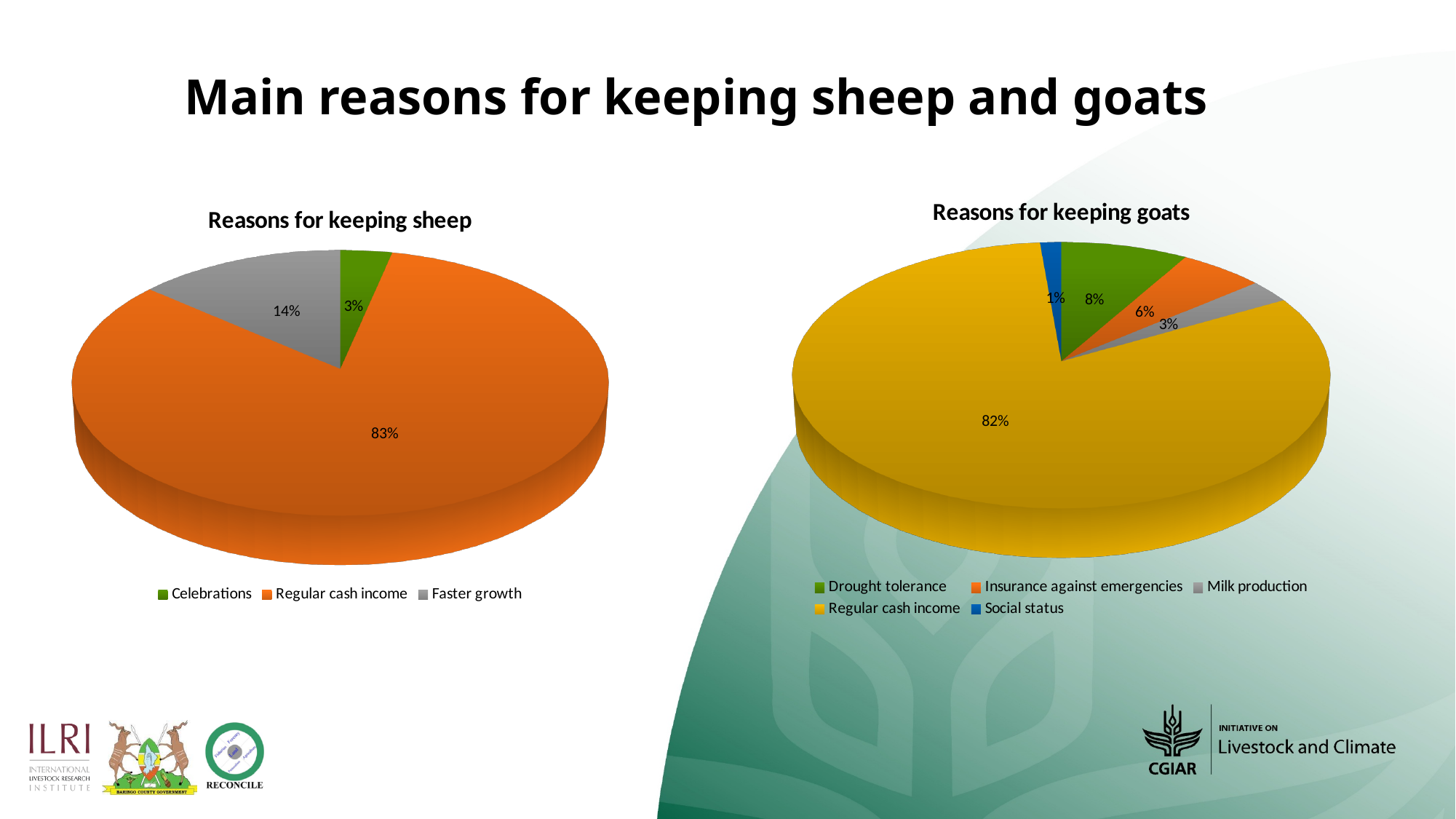
What type of chart is 'Reasons for keeping sheep'? Pie chart In the 'Reasons for keeping goats' chart, what share is Social status? 1% In the 'Reasons for keeping goats' chart, which is larger: Insurance against emergencies or Milk production? Insurance against emergencies How many categories does the legend of the 'Reasons for keeping goats' chart list? 5 In the 'Reasons for keeping goats' chart, which reason has the smallest share? Social status In the 'Reasons for keeping goats' chart, what share is Drought tolerance? 8% In the 'Reasons for keeping sheep' chart, which reason has the largest share? Regular cash income In the 'Reasons for keeping sheep' chart, what is the difference in percentage points between Faster growth and Celebrations? 11 In the 'Reasons for keeping sheep' chart, what share is Celebrations? 3% In the 'Reasons for keeping sheep' chart, what share is Faster growth? 14% In the 'Reasons for keeping goats' chart, what share is Regular cash income? 82% In the 'Reasons for keeping sheep' chart, what share is Regular cash income? 83%